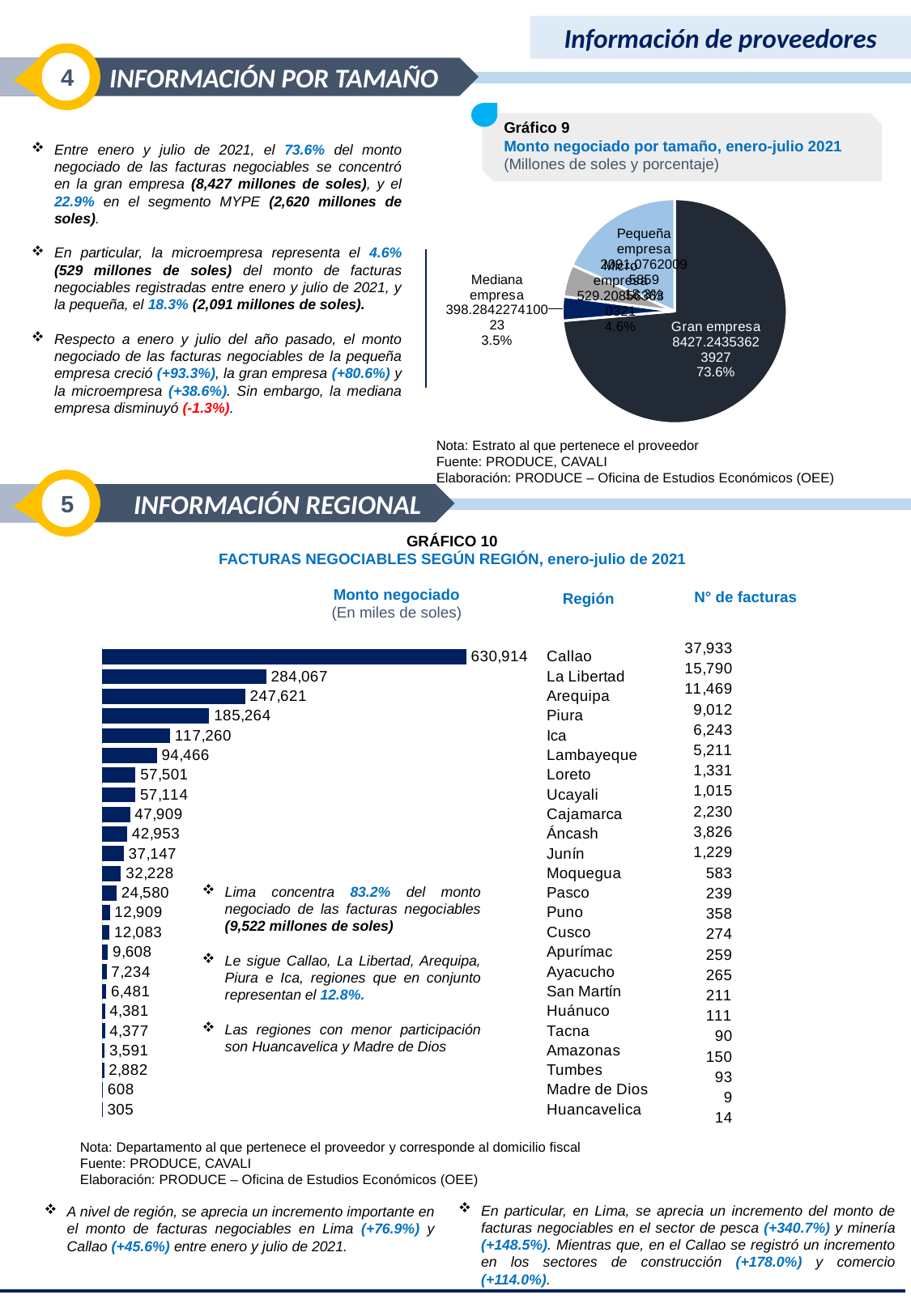
In Gráfico 9, what percentage of the negotiated amount corresponds to Mediana empresa? 3.5% In Gráfico 9, what percentage of the negotiated amount corresponds to Microempresa? 4.6% In Gráfico 10, what is the Monto negociado for Callao? 630,914 What kind of chart is Gráfico 9? Pie chart In Gráfico 10, do the Monto negociado values rise or fall going down the list of regions from Callao to Huancavelica? Fall In Gráfico 10, which region has the lowest Monto negociado? Huancavelica In Gráfico 9, what percentage of the negotiated amount corresponds to Gran empresa? 73.6% In Gráfico 10, what is the Monto negociado for Piura? 185,264 In Gráfico 10, what is the difference in Monto negociado between La Libertad and Arequipa? 36,446 In Gráfico 10, which region has the highest Monto negociado? Callao In Gráfico 10, how many regions are shown? 24 What kind of chart is Gráfico 10 (Monto negociado)? Bar chart